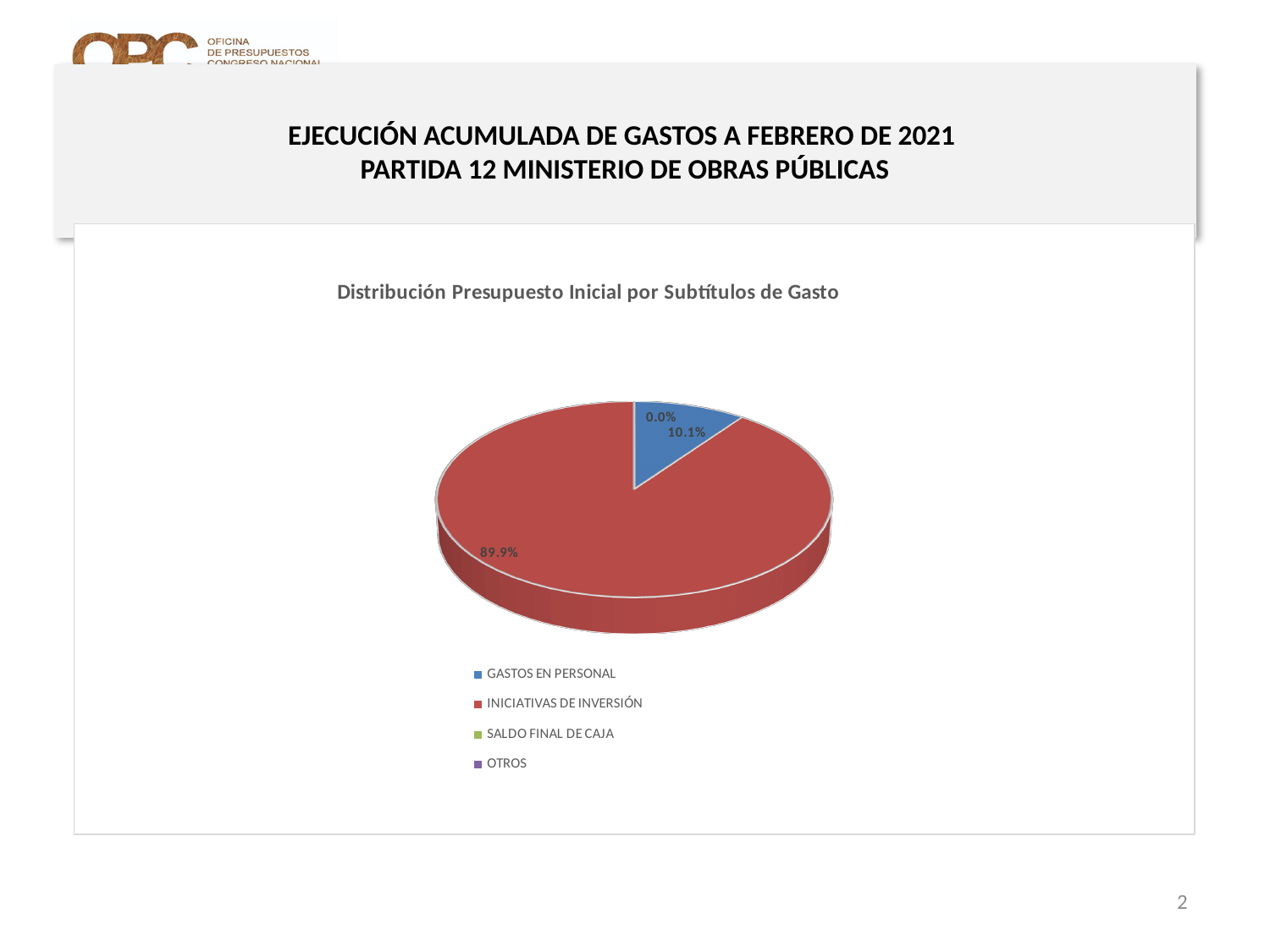
What percentage of the pie corresponds to INICIATIVAS DE INVERSIÓN? 89.9% How many categories does the legend list? 4 What is the difference in percentage points between the INICIATIVAS DE INVERSIÓN share and the GASTOS EN PERSONAL share? 79.8 percentage points What colour represents INICIATIVAS DE INVERSIÓN in the chart? Red What share of the pie does GASTOS EN PERSONAL take? 10.1% What kind of chart is shown on the slide? Pie chart Which is larger, the share for GASTOS EN PERSONAL or the share for INICIATIVAS DE INVERSIÓN? INICIATIVAS DE INVERSIÓN Is the share for INICIATIVAS DE INVERSIÓN greater or less than 50%? greater Which category has the largest share of the pie? INICIATIVAS DE INVERSIÓN What percentage of the pie corresponds to GASTOS EN PERSONAL? 10.1% What is the title of the chart? Distribución Presupuesto Inicial por Subtítulos de Gasto